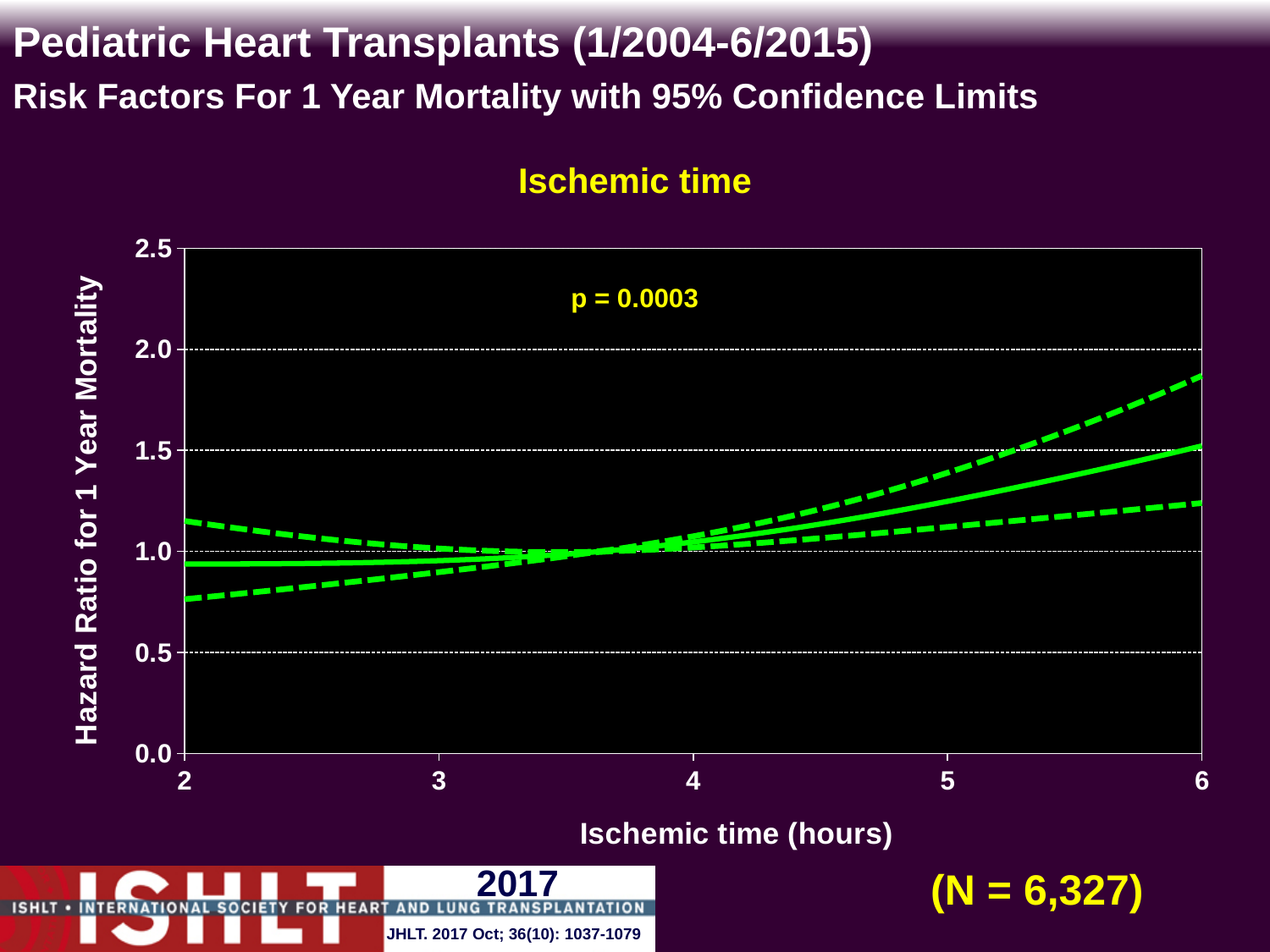
Is the upper 95% confidence limit at an ischemic time of 6 hours greater or less than 1.5? greater Is the hazard ratio (solid line) at an ischemic time of 6 hours greater or less than 2.0? less Is the hazard ratio (solid line) at an ischemic time of 6 hours greater or less than 1.0? greater What kind of chart is shown on the slide? line chart How many lines are plotted on the chart? 3 What p-value is printed on the chart? p = 0.0003 What is the highest value shown on the y axis? 2.5 Does the hazard ratio for 1 year mortality rise or fall as ischemic time increases from 2 to 6 hours? rise What is the sample size (N) shown on the slide? 6,327 What is the range of ischemic time shown on the x axis? 2 to 6 hours